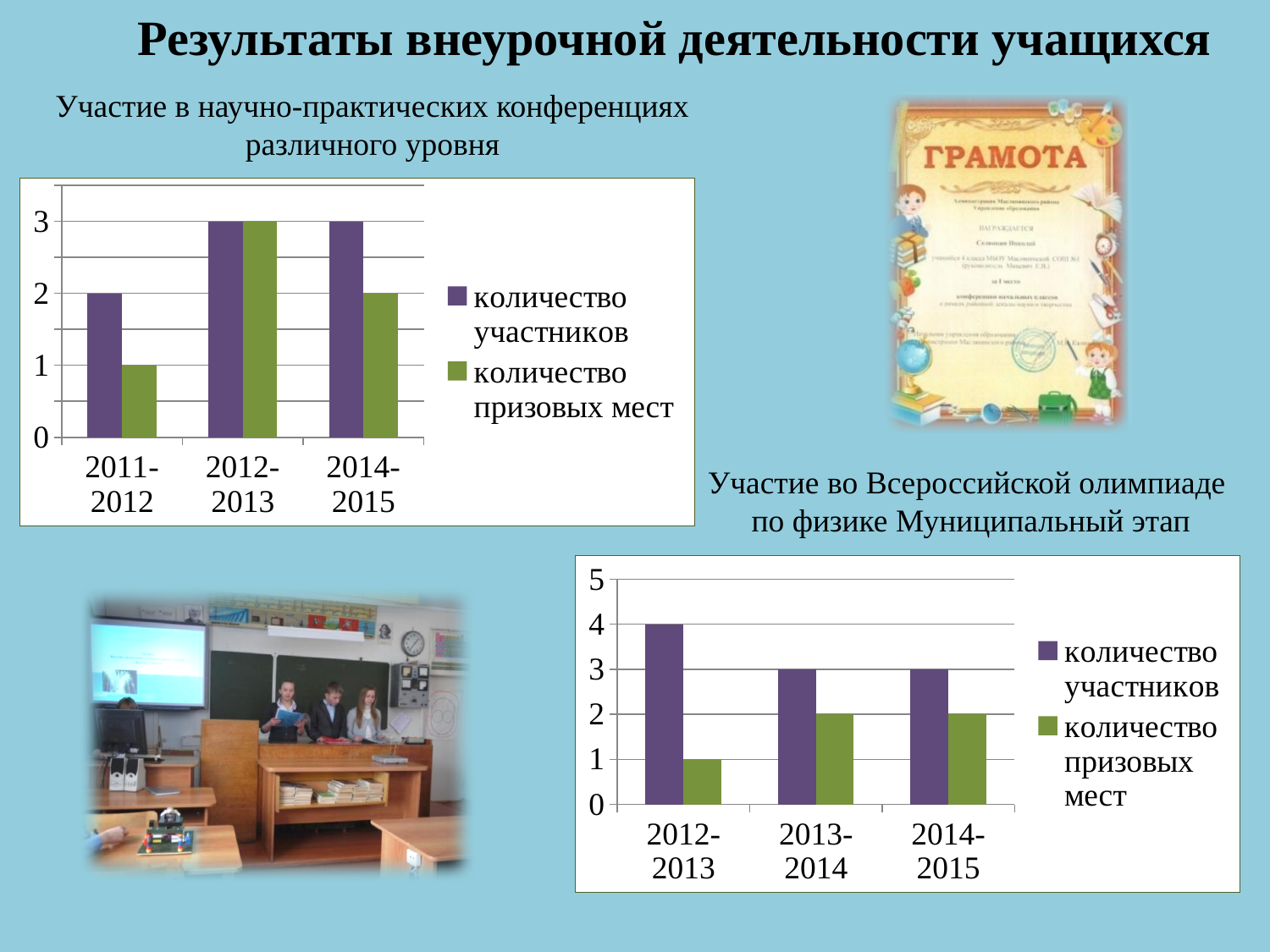
How many series does the legend of the chart 'Участие во Всероссийской олимпиаде по физике Муниципальный этап' list? 2 In the chart 'Участие во Всероссийской олимпиаде по физике Муниципальный этап', what is the value of 'количество призовых мест' for 2013-2014? 2 In the chart 'Участие в научно-практических конференциях различного уровня', how many periods are shown on the x axis? 3 In the chart 'Участие в научно-практических конференциях различного уровня', what is the value of 'количество участников' for 2011-2012? 2 In the chart 'Участие во Всероссийской олимпиаде по физике Муниципальный этап', does 'количество участников' rise or fall from 2012-2013 to 2013-2014? fall In the chart 'Участие в научно-практических конференциях различного уровня', what is the value of 'количество призовых мест' for 2012-2013? 3 In the chart 'Участие в научно-практических конференциях различного уровня', what is the difference between 'количество участников' and 'количество призовых мест' for 2014-2015? 1 In the chart 'Участие во Всероссийской олимпиаде по физике Муниципальный этап', is 'количество призовых мест' for 2012-2013 larger or smaller than for 2014-2015? smaller In the chart 'Участие во Всероссийской олимпиаде по физике Муниципальный этап', which period has the highest 'количество участников'? 2012-2013 In the chart 'Участие в научно-практических конференциях различного уровня', which period has the lowest 'количество призовых мест'? 2011-2012 In the chart 'Участие во Всероссийской олимпиаде по физике Муниципальный этап', what is the value of 'количество участников' for 2012-2013? 4 What type of chart is 'Участие в научно-практических конференциях различного уровня'? bar chart